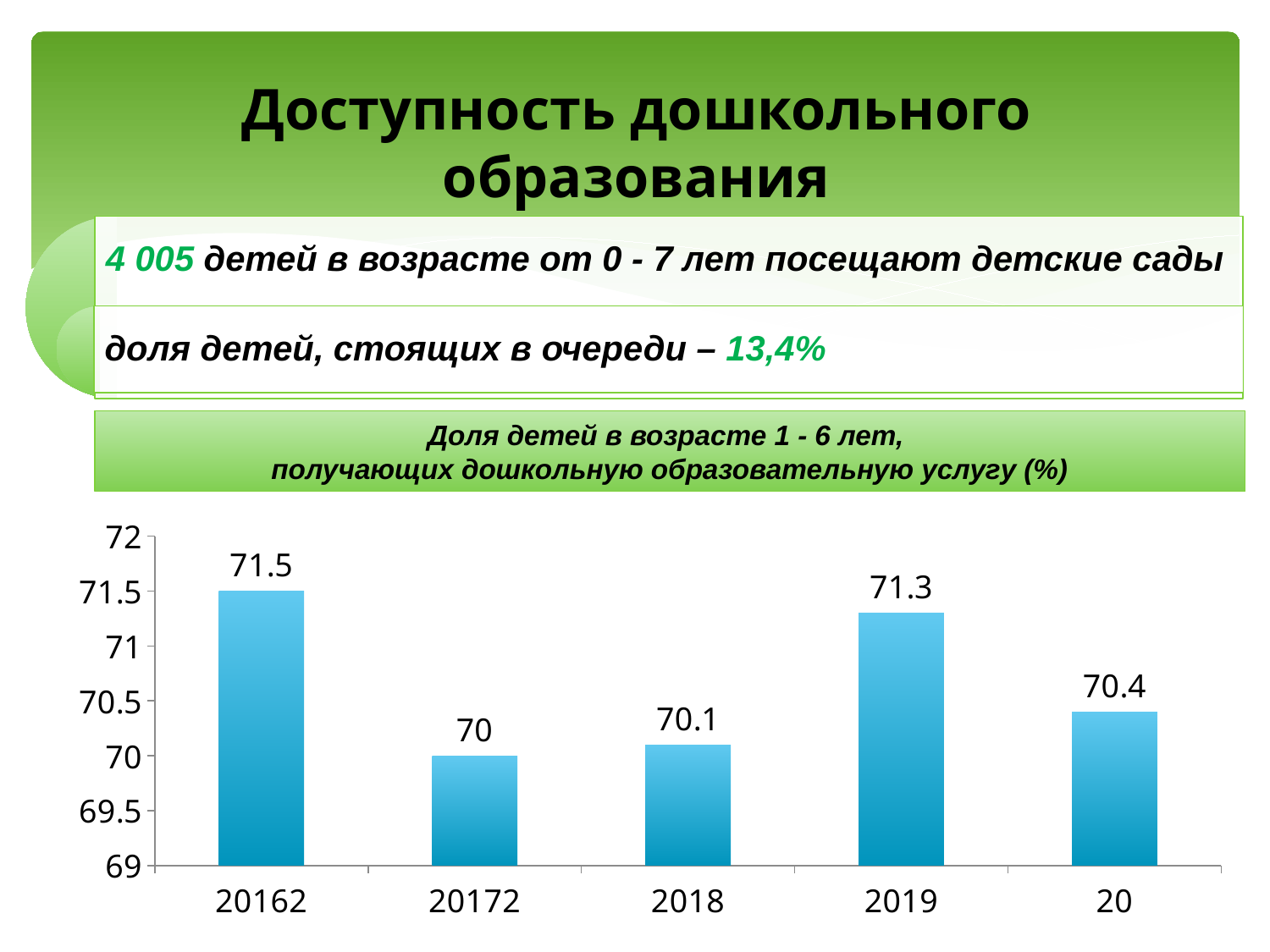
What is the difference between the values for 2019 and 2018? 1.2 What is the value for the category labelled 20162? 71.5 What is the value for the category labelled 2018? 70.1 What is the value for the last category, labelled 20? 70.4 What is the difference between the values for 20162 and 20172? 1.5 What kind of chart is shown on the slide? bar chart How many bars are shown in the chart? 5 What is the value for the category labelled 2019? 71.3 Which category has the lowest value? 20172 Which is larger, the value for 2019 or the value for 20? 2019 Which category has the highest value? 20162 What is the title of the chart? Доля детей в возрасте 1 - 6 лет, получающих дошкольную образовательную услугу (%)